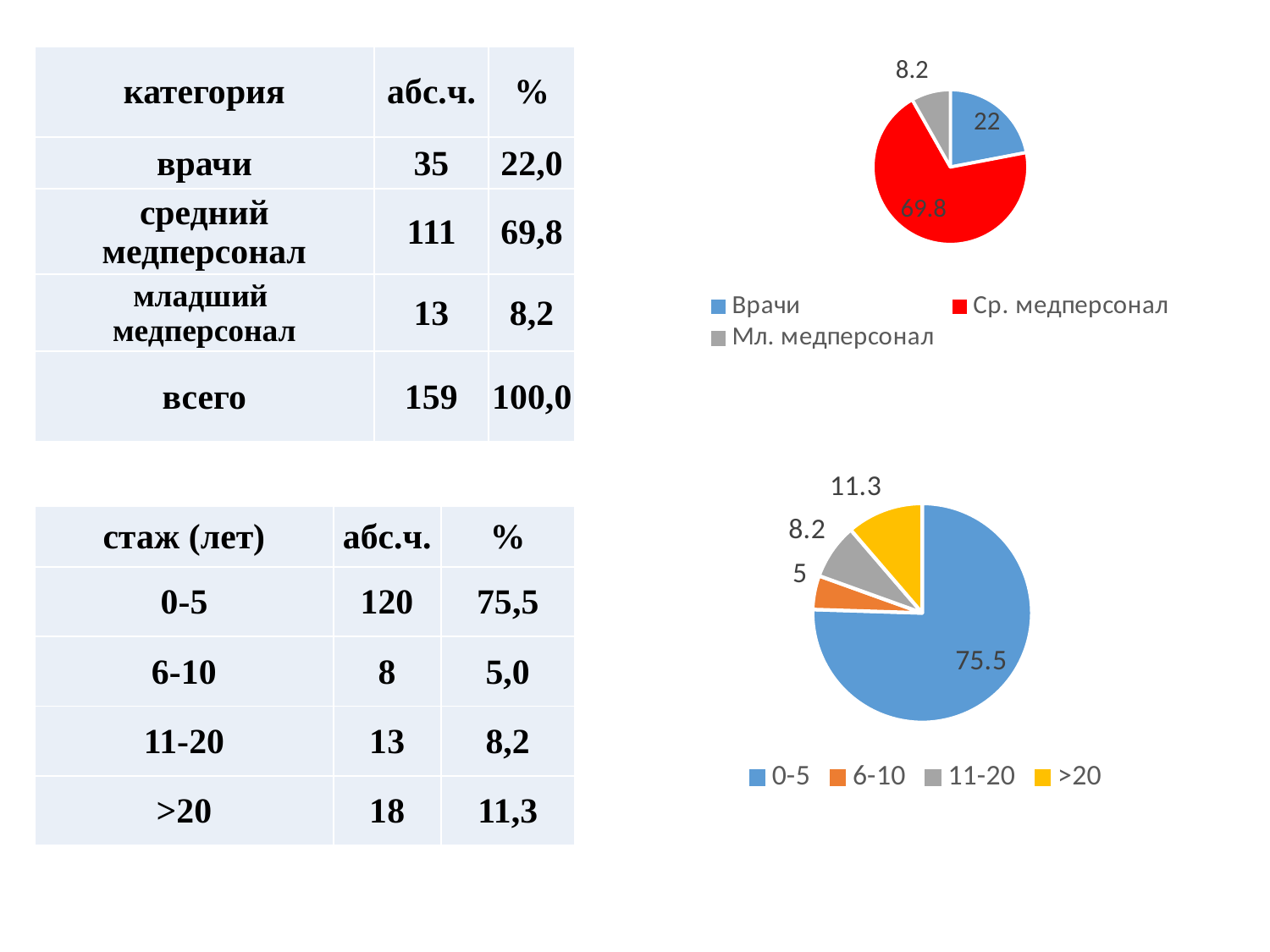
In the top-right pie chart, what value is shown for Врачи? 22 In the bottom-right pie chart, which category has the smallest slice? 6-10 How many categories does the legend of the top-right pie chart list? 3 What type of chart is shown at the top right of the slide? pie chart In the bottom-right pie chart, what colour is the 0-5 slice? blue In the bottom-right pie chart, what value is shown for the 0-5 slice? 75.5 In the top-right pie chart, what is the difference between the values for Ср. медперсонал and Врачи? 47.8 In the top-right pie chart, what value is shown for Ср. медперсонал? 69.8 In the top-right pie chart, which category has the smallest slice? Мл. медперсонал In the bottom-right pie chart, what value is shown for the >20 slice? 11.3 How many slices does the bottom-right pie chart have? 4 In the bottom-right pie chart, which is larger: the 11-20 slice or the >20 slice? >20